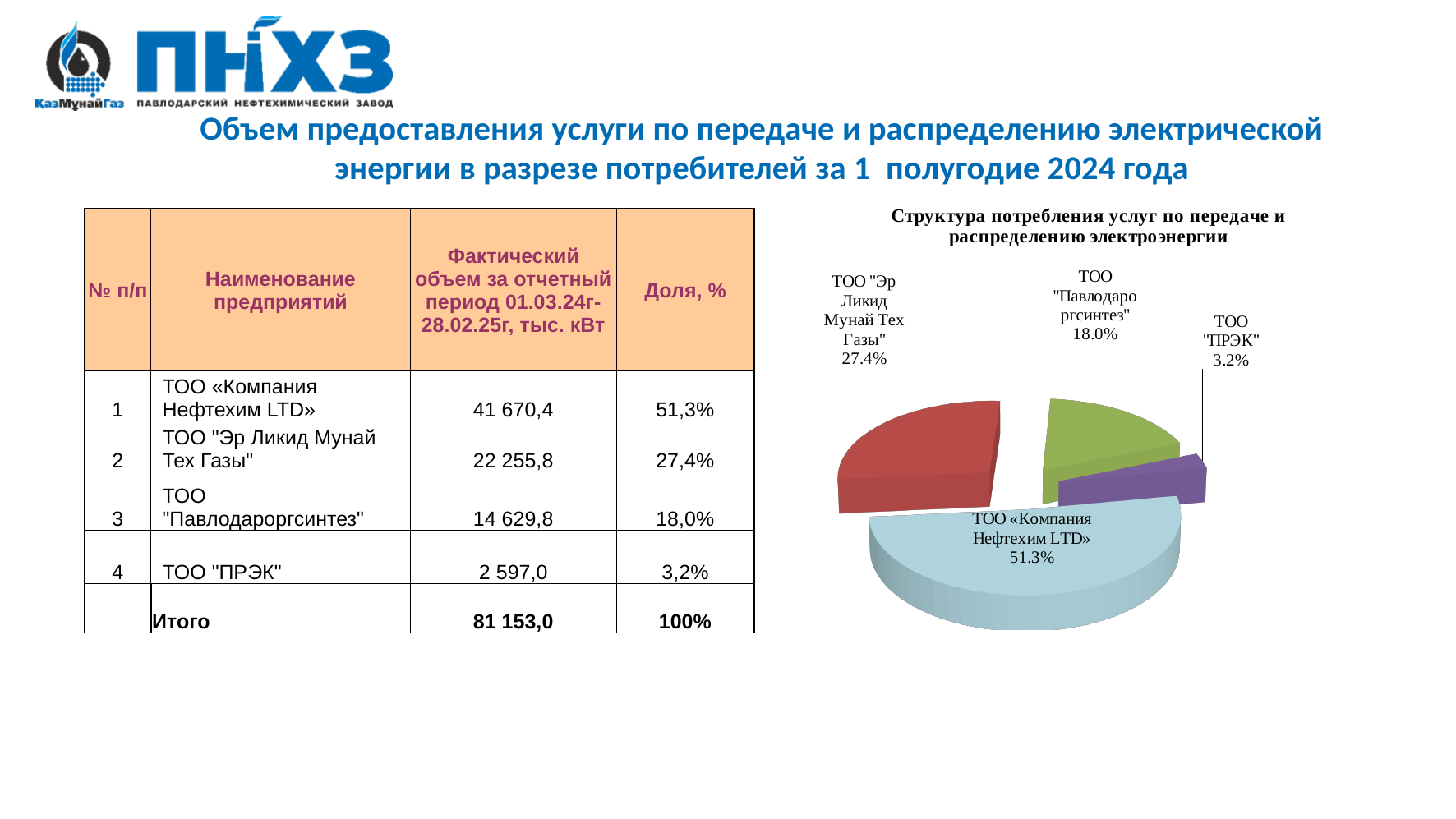
What kind of chart is shown on the slide? Pie chart What share of the pie chart does ТОО «Компания Нефтехим LTD» have? 51.3% What is the title of the pie chart? Структура потребления услуг по передаче и распределению электроэнергии What share of the pie chart does ТОО "Павлодароргсинтез" have? 18.0% What share of the pie chart does ТОО "ПРЭК" have? 3.2% By how many percentage points does the share of ТОО «Компания Нефтехим LTD» exceed that of ТОО "Эр Ликид Мунай Тех Газы" in the pie chart? 23.9 Which company has the smallest slice in the pie chart? ТОО "ПРЭК" What colour is the slice for ТОО «Компания Нефтехим LTD» in the pie chart? Light blue Which company has the largest slice in the pie chart? ТОО «Компания Нефтехим LTD» Which slice is larger in the pie chart: ТОО "Эр Ликид Мунай Тех Газы" or ТОО "Павлодароргсинтез"? ТОО "Эр Ликид Мунай Тех Газы" How many slices does the pie chart have? 4